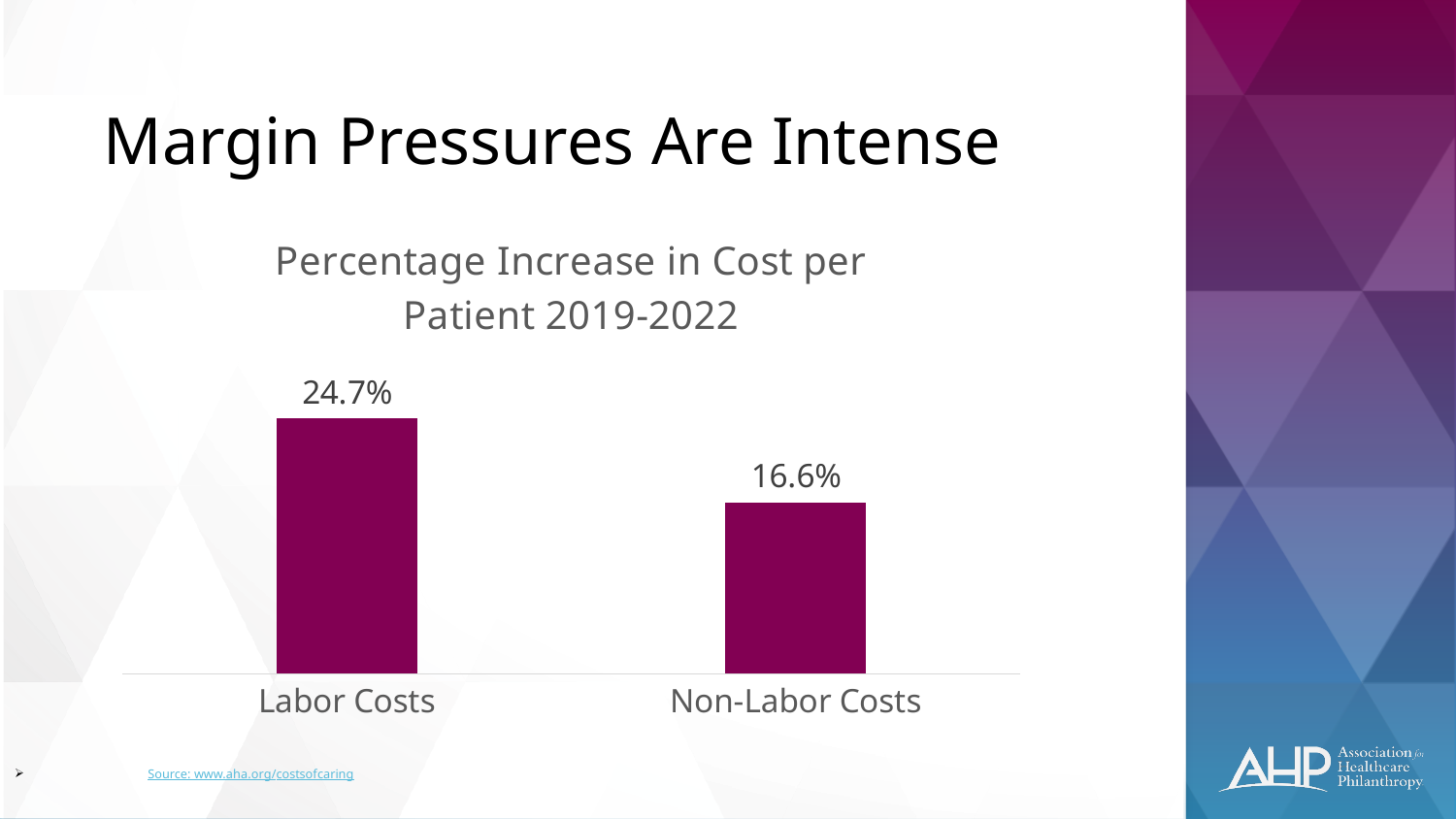
Which category shows the highest percentage increase in cost per patient? Labor Costs What is the difference in percentage points between the Labor Costs and Non-Labor Costs increases? 8.1 What colour are the bars in the chart? Purple What is the percentage increase in cost per patient for Non-Labor Costs? 16.6% Which category shows the lowest percentage increase in cost per patient? Non-Labor Costs What is the title of the chart? Percentage Increase in Cost per Patient 2019-2022 What is the percentage increase in cost per patient for Labor Costs? 24.7% How many categories are shown in the chart? 2 Which is larger, the increase for Labor Costs or for Non-Labor Costs? Labor Costs What kind of chart is shown on the slide? Bar chart